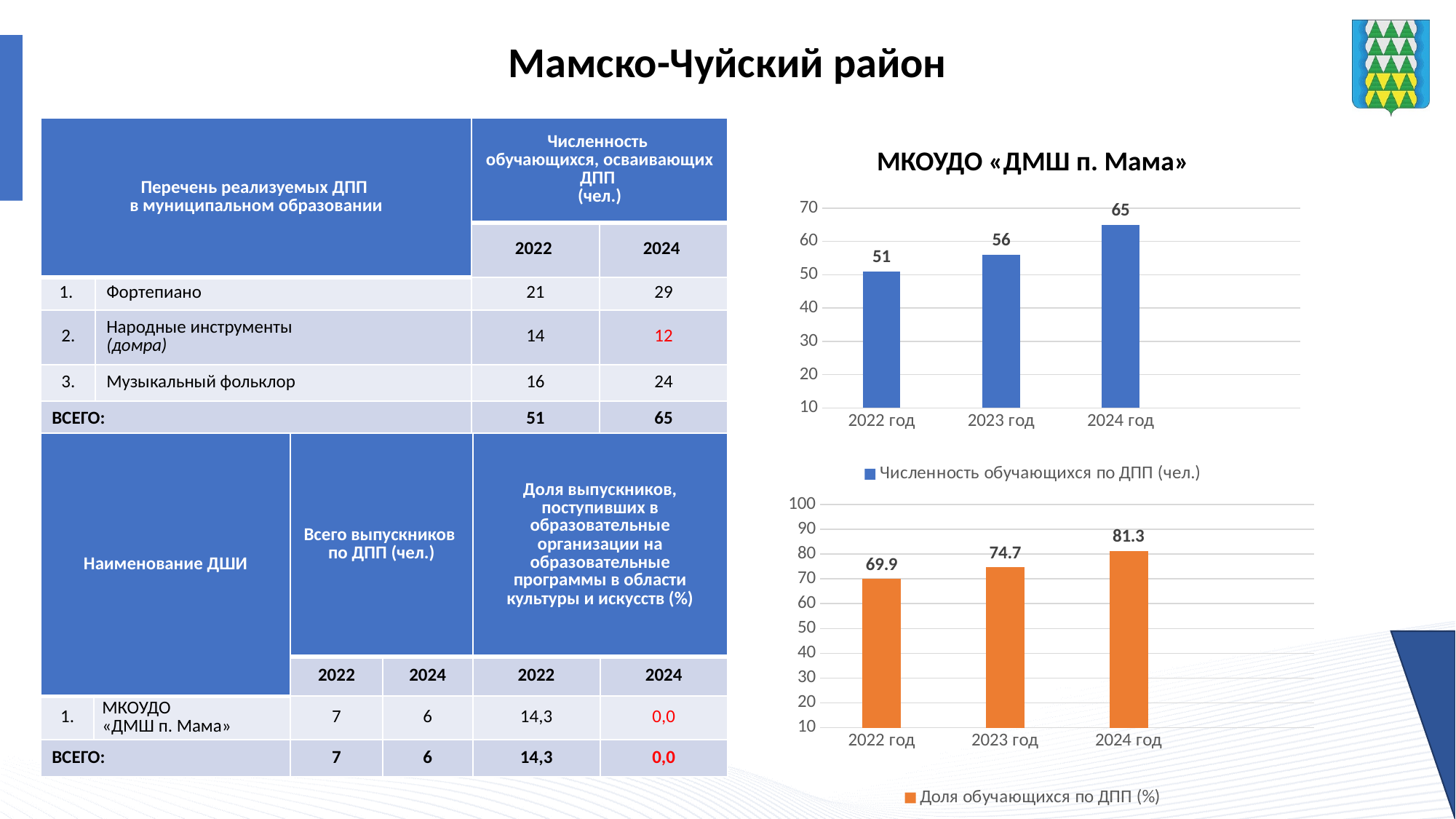
In the bottom chart (Доля обучающихся по ДПП), what is the value for 2022 год? 69.9 In the top chart (Численность обучающихся по ДПП), what is the value for 2024 год? 65 In the bottom chart (Доля обучающихся по ДПП), what is the value for 2024 год? 81.3 What type of chart is the top chart (Численность обучающихся по ДПП)? bar chart In the bottom chart (Доля обучающихся по ДПП), is the value for 2024 год greater or less than 80? greater In the top chart (Численность обучающихся по ДПП), what is the difference between the 2024 год and 2022 год values? 14 In the top chart (Численность обучающихся по ДПП), what is the value for 2023 год? 56 In the top chart (Численность обучающихся по ДПП), which year has the lowest value? 2022 год In the bottom chart (Доля обучающихся по ДПП), which is larger: the value for 2022 год or 2023 год? 2023 год In the bottom chart (Доля обучающихся по ДПП), which year has the highest value? 2024 год How many bars are plotted in the bottom chart (Доля обучающихся по ДПП)? 3 In the top chart (Численность обучающихся по ДПП), do the values rise or fall from 2022 год to 2024 год? rise